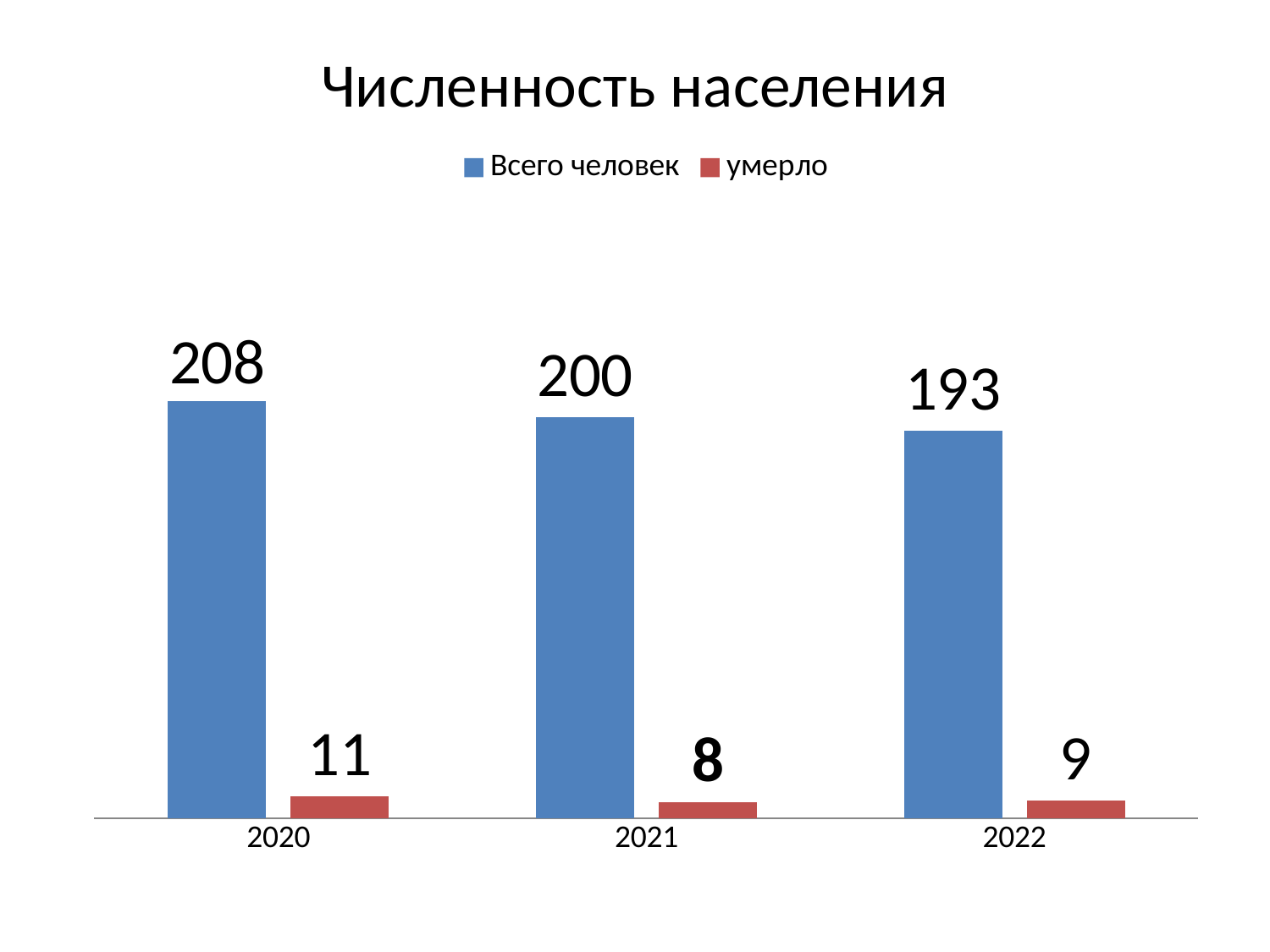
What is the title of the chart? Численность населения How many series does the legend list? 2 How many years are shown on the x axis? 3 Which year has the lowest value for "умерло"? 2021 Which is larger: "умерло" in 2020 or "умерло" in 2022? 2020 Which year has the highest value for "Всего человек"? 2020 What is the value of "Всего человек" for 2020? 208 Does the "Всего человек" series rise or fall from 2020 to 2022? fall What kind of chart is shown on the slide? bar chart What is the value of "умерло" for 2021? 8 What is the difference between the "Всего человек" values for 2020 and 2022? 15 What is the value of "Всего человек" for 2022? 193